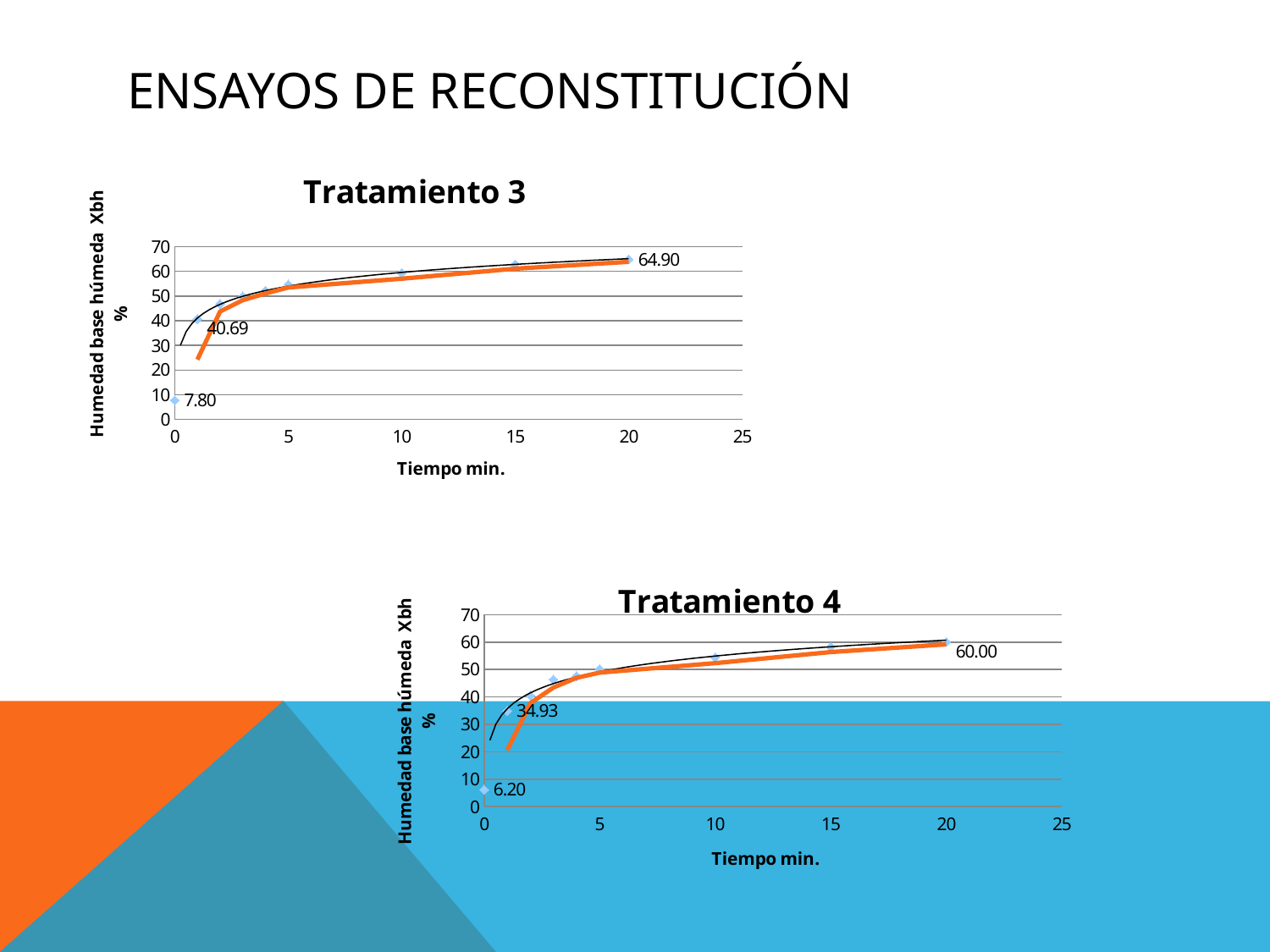
In the Tratamiento 4 chart, what is the difference between the labelled value at 20 minutes and the labelled value at time 0? 53.80 In the Tratamiento 3 chart, what is the labelled value at time 0? 7.80 In the Tratamiento 3 chart, what is the labelled value of the second data point (at 1 minute)? 40.69 In the Tratamiento 4 chart, do the values rise or fall as time increases? rise In the Tratamiento 3 chart, what is the title of the horizontal axis? Tiempo min. In the Tratamiento 4 chart, what is the labelled value at 20 minutes? 60.00 In the Tratamiento 3 chart, is the value at 10 minutes greater or less than 50? greater In the Tratamiento 4 chart, what is the labelled value of the second data point (at 1 minute)? 34.93 In the Tratamiento 3 chart, what is the labelled value at 20 minutes? 64.90 Which chart shows the higher labelled value at 20 minutes, Tratamiento 3 or Tratamiento 4? Tratamiento 3 In the Tratamiento 4 chart, what is the labelled value at time 0? 6.20 In the Tratamiento 3 chart, what is the difference between the labelled value at 20 minutes and the labelled value at time 0? 57.10